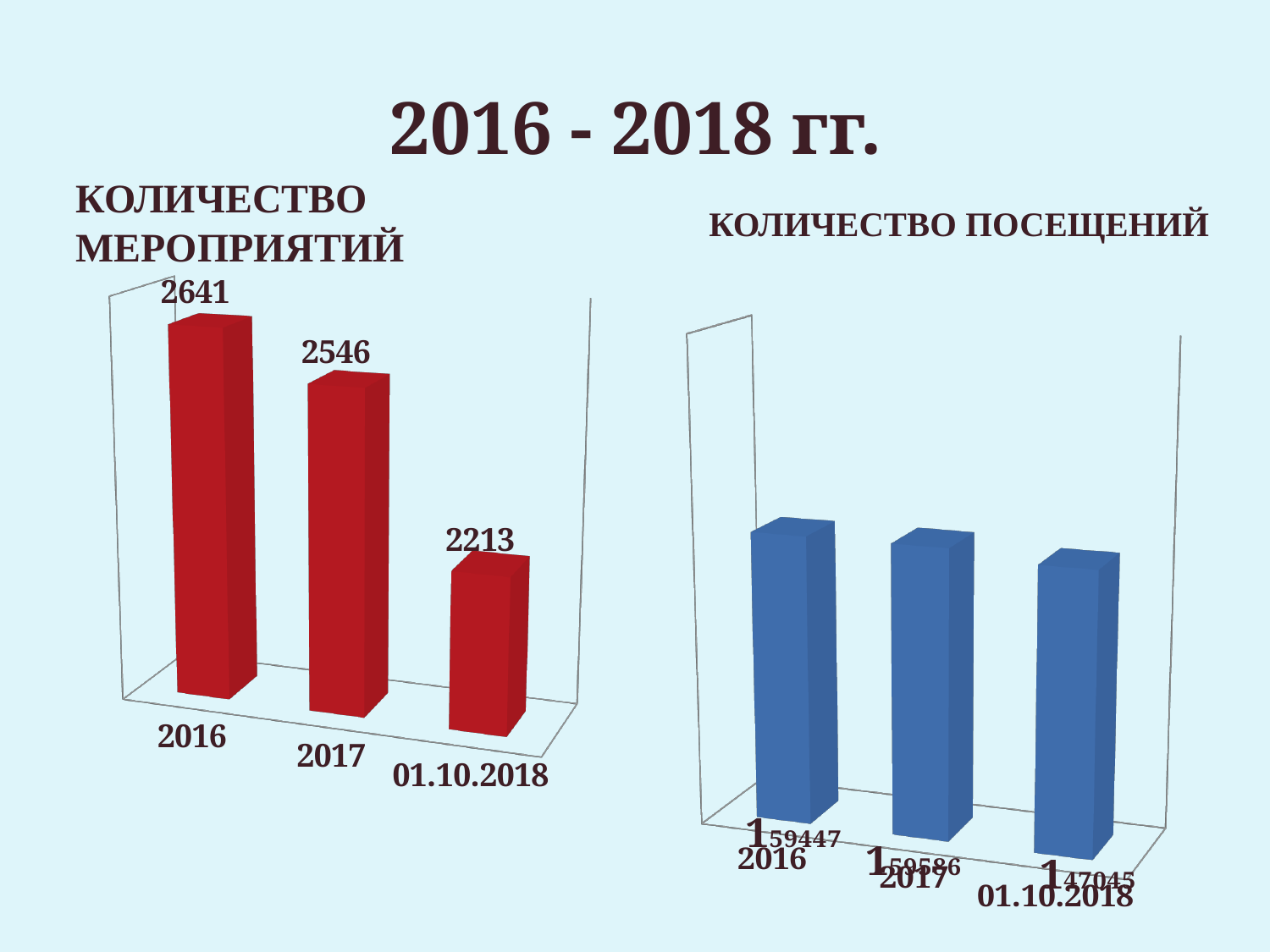
In the chart titled КОЛИЧЕСТВО МЕРОПРИЯТИЙ, how many categories are shown? 3 What kind of chart is the chart titled КОЛИЧЕСТВО ПОСЕЩЕНИЙ? bar chart In the chart titled КОЛИЧЕСТВО МЕРОПРИЯТИЙ, which category has the lowest value? 01.10.2018 In the chart titled КОЛИЧЕСТВО МЕРОПРИЯТИЙ, what is the difference between the values for 2016 and 2017? 95 In the chart titled КОЛИЧЕСТВО МЕРОПРИЯТИЙ, what is the value for 2016? 2641 In the chart titled КОЛИЧЕСТВО МЕРОПРИЯТИЙ, what is the difference between the values for 2017 and 01.10.2018? 333 In the chart titled КОЛИЧЕСТВО МЕРОПРИЯТИЙ, do the values rise or fall from 2016 to 01.10.2018? fall In the chart titled КОЛИЧЕСТВО МЕРОПРИЯТИЙ, what is the value for 01.10.2018? 2213 In the chart titled КОЛИЧЕСТВО МЕРОПРИЯТИЙ, which category has the highest value? 2016 In the chart titled КОЛИЧЕСТВО МЕРОПРИЯТИЙ, which is larger: the value for 2017 or the value for 01.10.2018? 2017 In the chart titled КОЛИЧЕСТВО МЕРОПРИЯТИЙ, what is the value for 2017? 2546 In the chart titled КОЛИЧЕСТВО ПОСЕЩЕНИЙ, which category has the lowest value? 01.10.2018